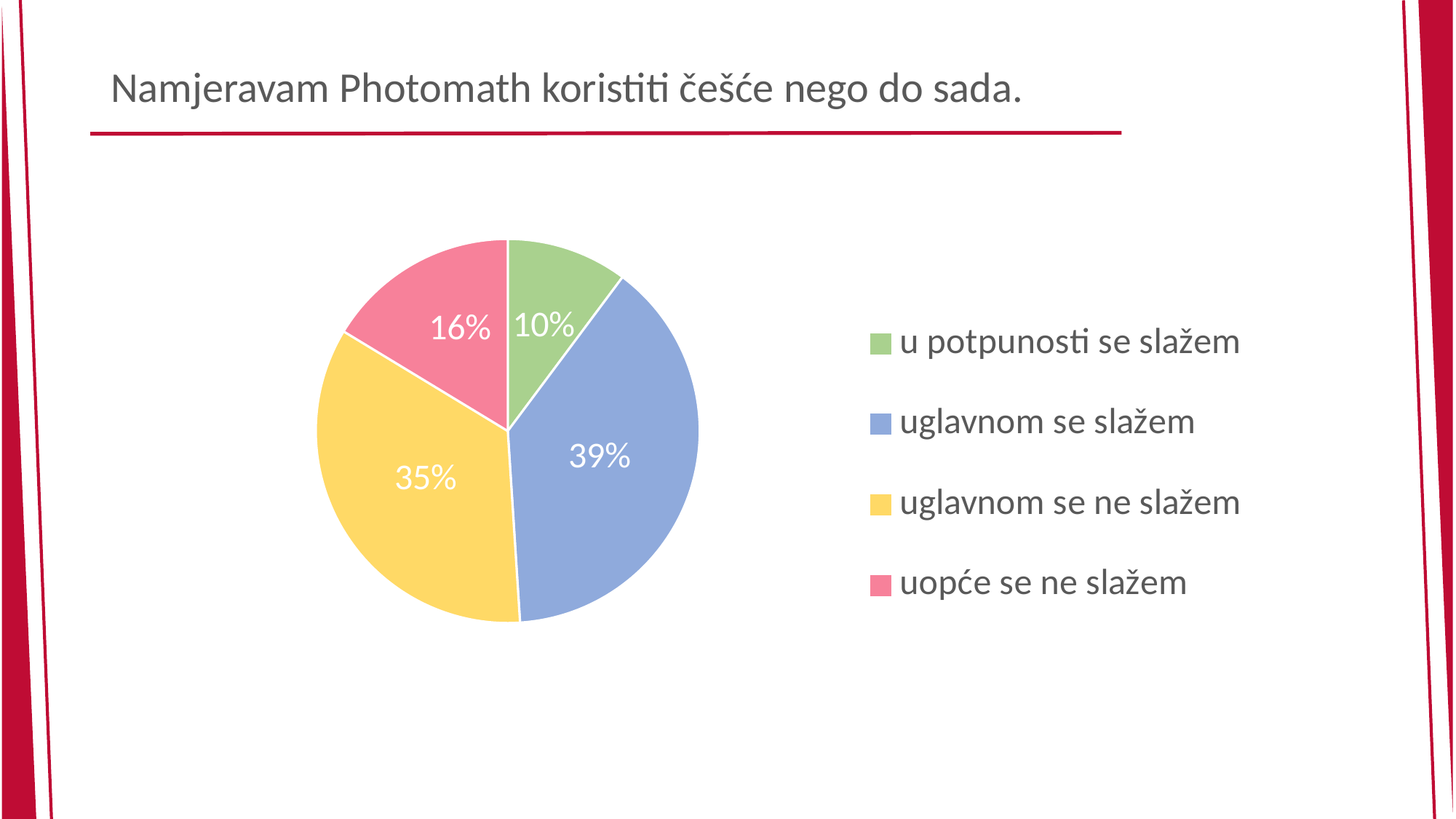
Which category has the largest slice of the pie? uglavnom se slažem What kind of chart is shown on the slide? pie chart Which category has the smallest slice of the pie? u potpunosti se slažem What share of the pie does "uglavnom se slažem" have? 39% What share of the pie does "uopće se ne slažem" have? 16% What share of the pie does "uglavnom se ne slažem" have? 35% What is the difference in percentage points between "uglavnom se slažem" and "uglavnom se ne slažem"? 4 What is the difference in percentage points between "uopće se ne slažem" and "u potpunosti se slažem"? 6 How many categories does the pie chart show? 4 Which is larger: the slice for "uopće se ne slažem" or the slice for "u potpunosti se slažem"? uopće se ne slažem What colour is the slice for "uglavnom se ne slažem"? yellow